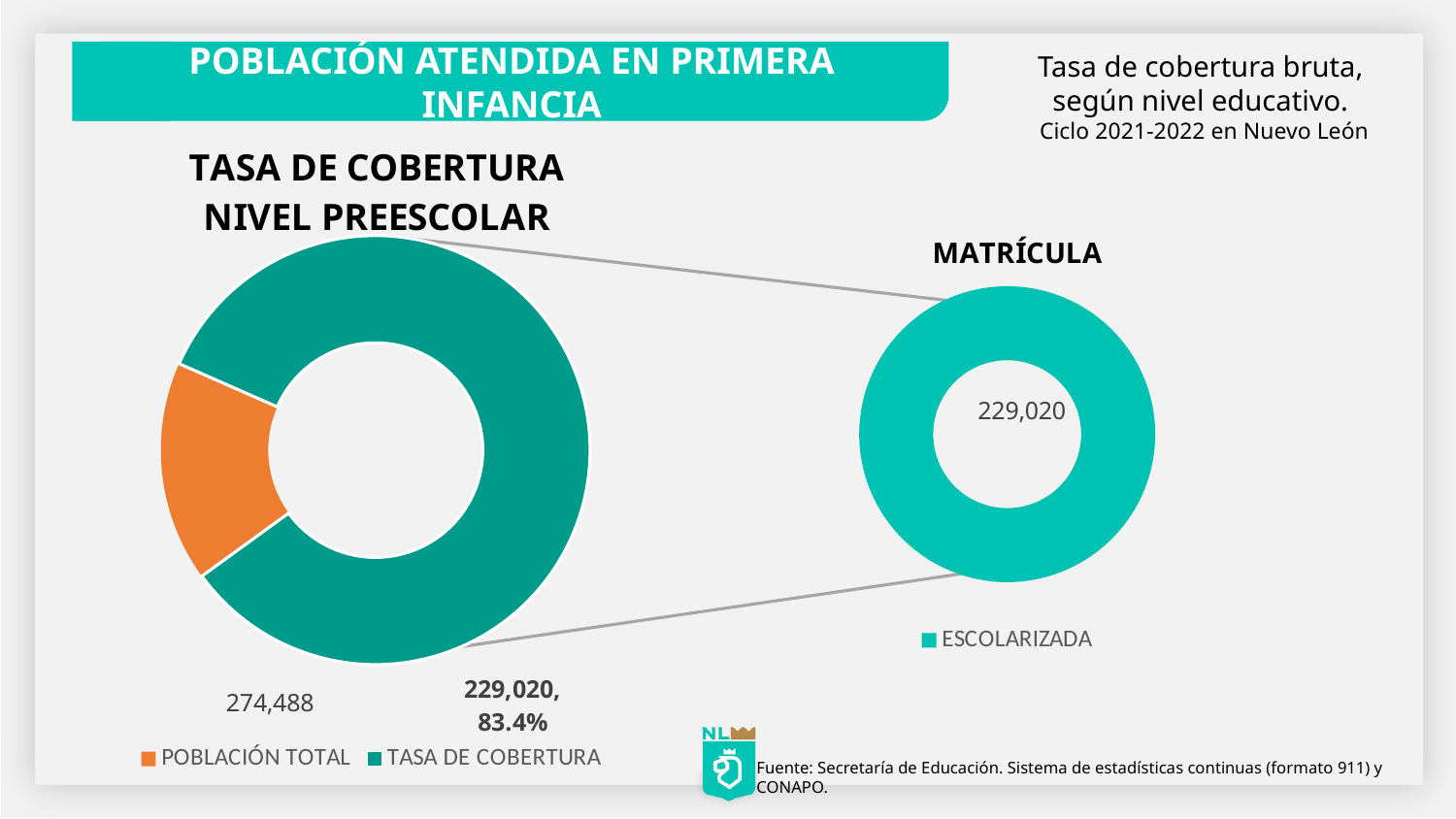
In the TASA DE COBERTURA NIVEL PREESCOLAR chart, what value is shown for TASA DE COBERTURA? 229,020 How many entries does the legend of the TASA DE COBERTURA NIVEL PREESCOLAR chart list? 2 What is the legend entry of the MATRÍCULA chart? ESCOLARIZADA In the TASA DE COBERTURA NIVEL PREESCOLAR chart, what percentage is shown in the label for TASA DE COBERTURA? 83.4% Which category takes up the largest share of the TASA DE COBERTURA NIVEL PREESCOLAR doughnut? TASA DE COBERTURA What kind of chart is the TASA DE COBERTURA NIVEL PREESCOLAR chart? Doughnut (pie) chart In the TASA DE COBERTURA NIVEL PREESCOLAR chart, what value is shown for POBLACIÓN TOTAL? 274,488 In the TASA DE COBERTURA NIVEL PREESCOLAR chart, which slice is larger, POBLACIÓN TOTAL or TASA DE COBERTURA? TASA DE COBERTURA How many slices does the MATRÍCULA doughnut chart have? 1 What is the title of the chart on the left side of the slide? TASA DE COBERTURA NIVEL PREESCOLAR How many categories are plotted in the TASA DE COBERTURA NIVEL PREESCOLAR chart? 2 In the MATRÍCULA chart, what value is shown in the centre of the doughnut? 229,020